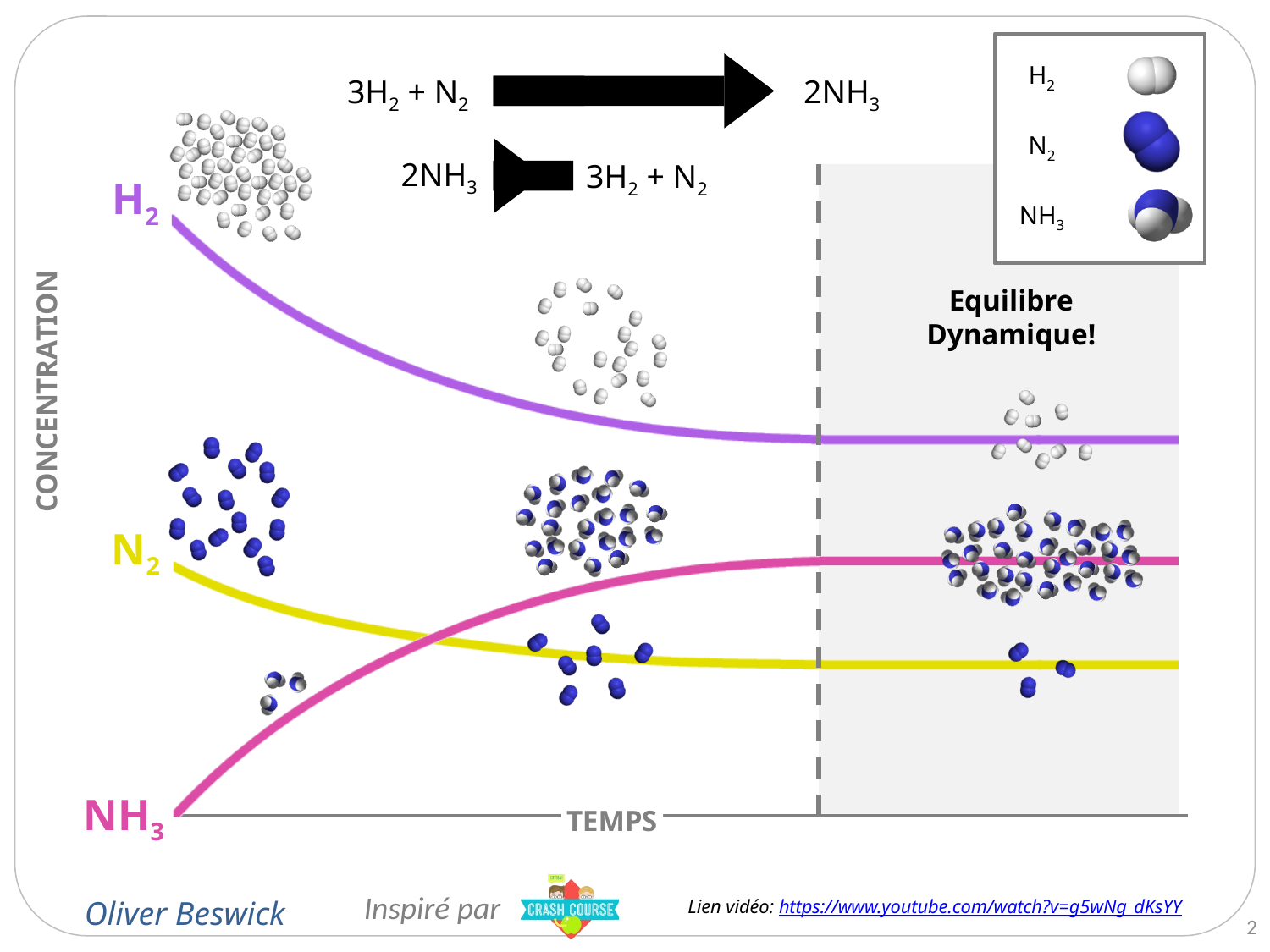
Which substance has the lowest concentration at the start of the chart? NH3 In the shaded equilibrium region, which has the higher concentration, NH3 or N2? NH3 Does the concentration of H2 rise or fall over time before levelling off? Fall What kind of chart is shown on the slide? Line chart What is the label of the vertical axis of the chart? CONCENTRATION What is the label of the horizontal axis of the chart? TEMPS Does the concentration of NH3 rise or fall over time before levelling off? Rise Which substance has the highest concentration in the shaded equilibrium region? H2 Does the concentration of N2 rise or fall over time before levelling off? Fall Which substance has the highest concentration at the start of the chart? H2 How many substances (curves) are plotted on the chart? 3 Which substance has the lowest concentration in the shaded equilibrium region? N2